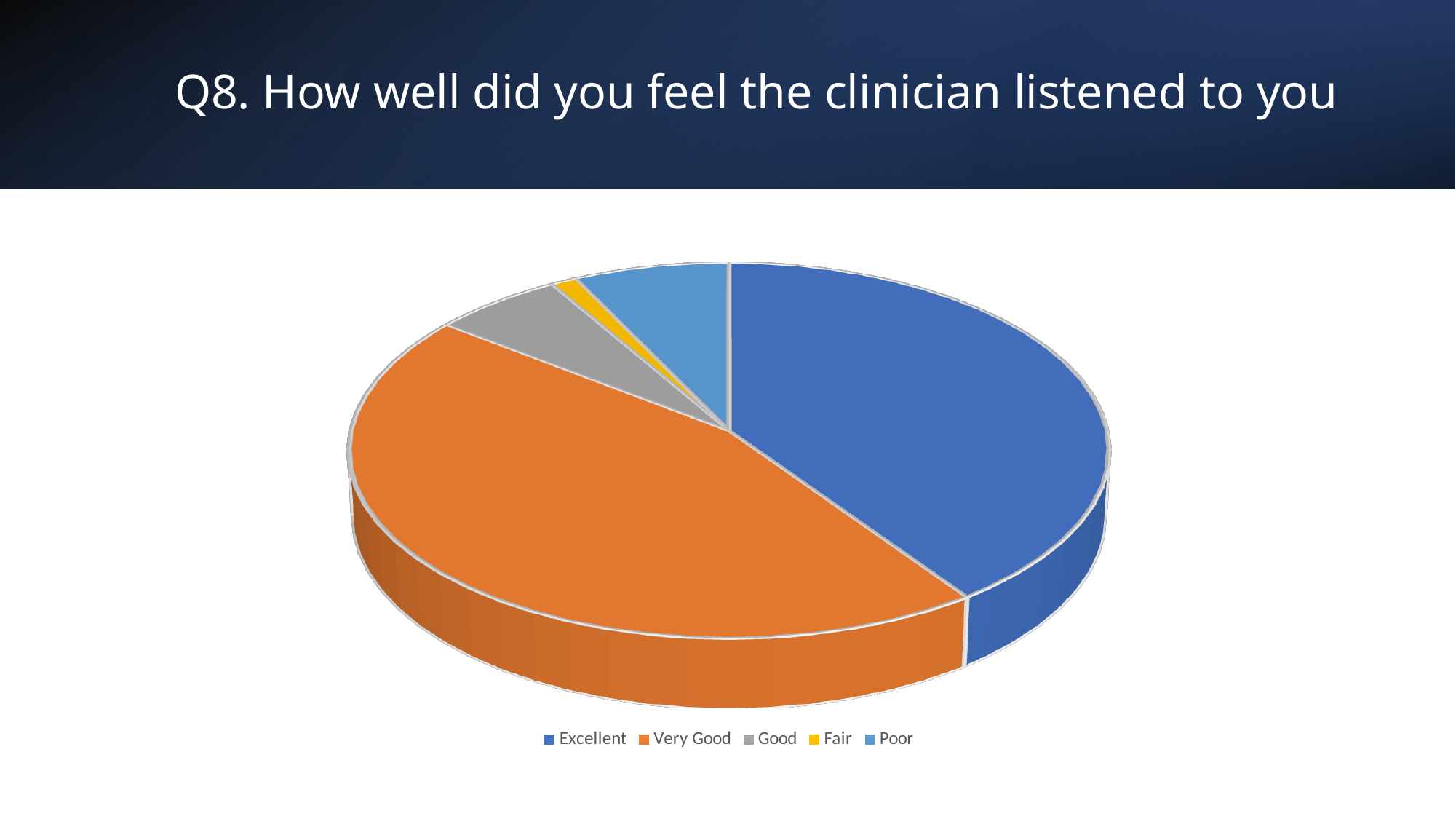
Which slice is larger, Good or Fair? Good Which slice is larger, Excellent or Good? Excellent What is the title of the slide containing the pie chart? Q8. How well did you feel the clinician listened to you Which slice is larger, Poor or Fair? Poor How many categories does the pie chart show? 5 What colour is the Very Good slice in the pie chart? Orange Which category has the smallest slice of the pie? Fair What kind of chart is shown on the slide? Pie chart